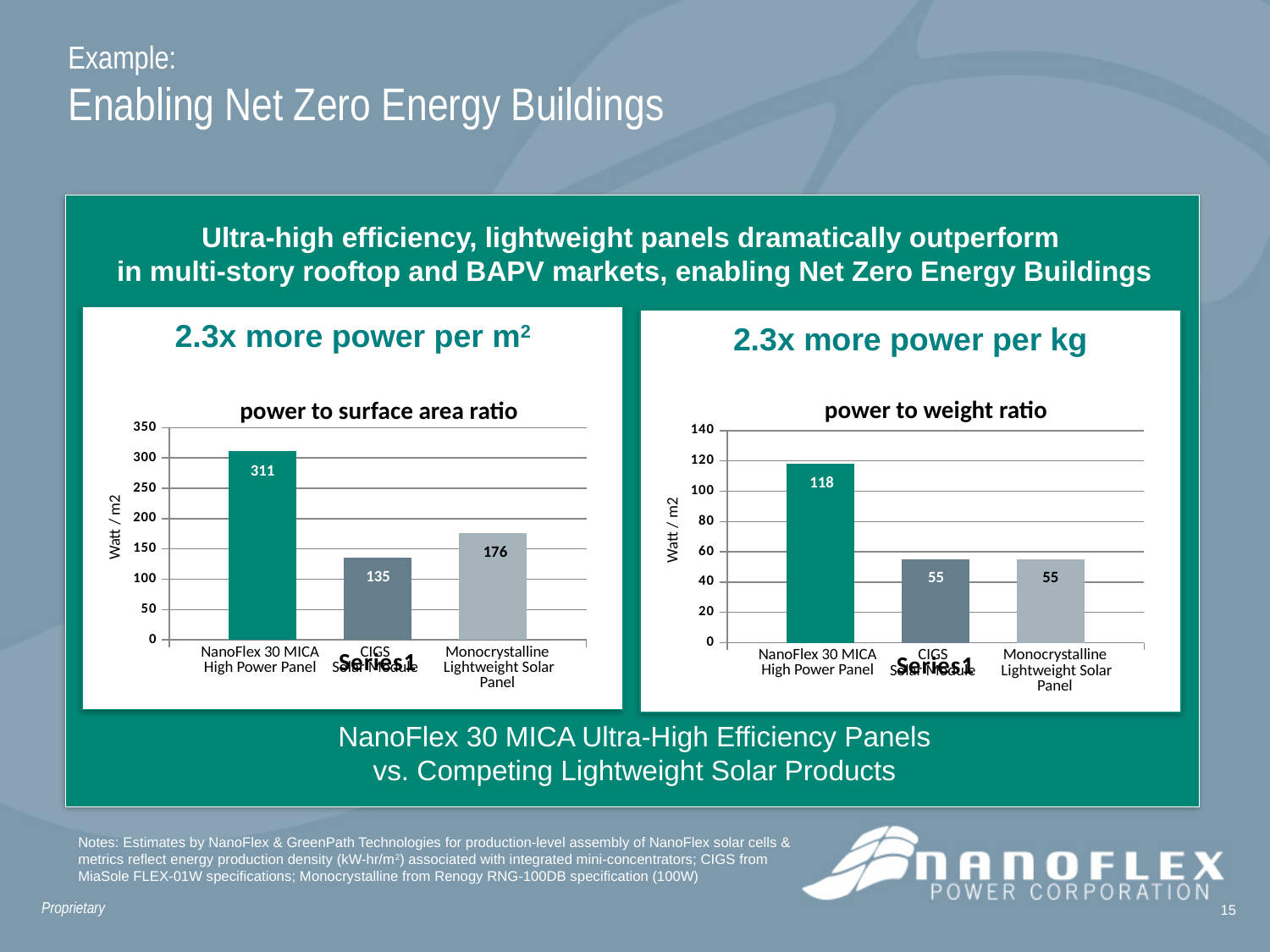
In the 'power to surface area ratio' chart, what is the difference between the NanoFlex 30 MICA High Power Panel and the CIGS value? 176 In the 'power to surface area ratio' chart, which is larger: the Monocrystalline Lightweight Solar Panel or the CIGS value? Monocrystalline Lightweight Solar Panel In the 'power to weight ratio' chart, which category has the highest value? NanoFlex 30 MICA High Power Panel In the 'power to weight ratio' chart, what is the value for the NanoFlex 30 MICA High Power Panel? 118 In the 'power to surface area ratio' chart, which category has the lowest value? CIGS What is the y-axis label of the 'power to surface area ratio' chart? Watt / m2 In the 'power to weight ratio' chart, what is the value for the CIGS category? 55 In the 'power to weight ratio' chart, what is the difference between the NanoFlex 30 MICA High Power Panel and the Monocrystalline Lightweight Solar Panel? 63 In the 'power to surface area ratio' chart, what is the value for the Monocrystalline Lightweight Solar Panel? 176 How many categories are shown in the 'power to weight ratio' chart? 3 What type of chart is the 'power to surface area ratio' chart? Bar chart In the 'power to surface area ratio' chart, what is the value for the NanoFlex 30 MICA High Power Panel? 311